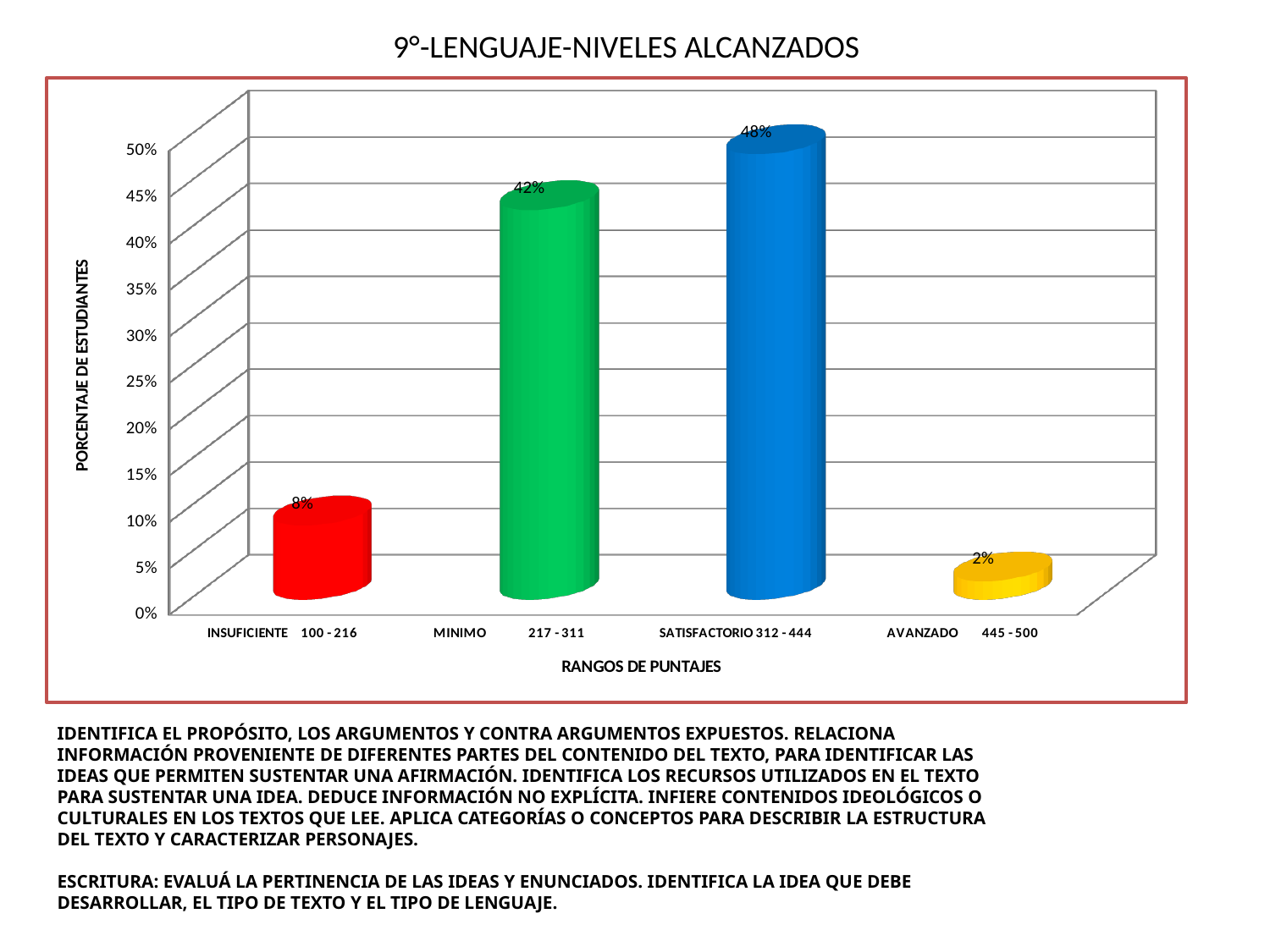
What percentage of students is shown for the SATISFACTORIO 312 - 444 category? 48% What is the title of the chart? 9°-LENGUAJE-NIVELES ALCANZADOS What kind of chart is shown on the slide? Bar chart What percentage of students is shown for the AVANZADO 445 - 500 category? 2% How many categories are shown on the x axis of the chart? 4 What percentage of students is shown for the MINIMO 217 - 311 category? 42% Which category has the highest percentage of students? SATISFACTORIO 312 - 444 Which category has the lowest percentage of students? AVANZADO 445 - 500 What is the difference in percentage points between the SATISFACTORIO 312 - 444 and MINIMO 217 - 311 categories? 6% What percentage of students is shown for the INSUFICIENTE 100 - 216 category? 8% Which has a larger percentage of students, INSUFICIENTE 100 - 216 or AVANZADO 445 - 500? INSUFICIENTE 100 - 216 What is the label of the vertical axis of the chart? PORCENTAJE DE ESTUDIANTES